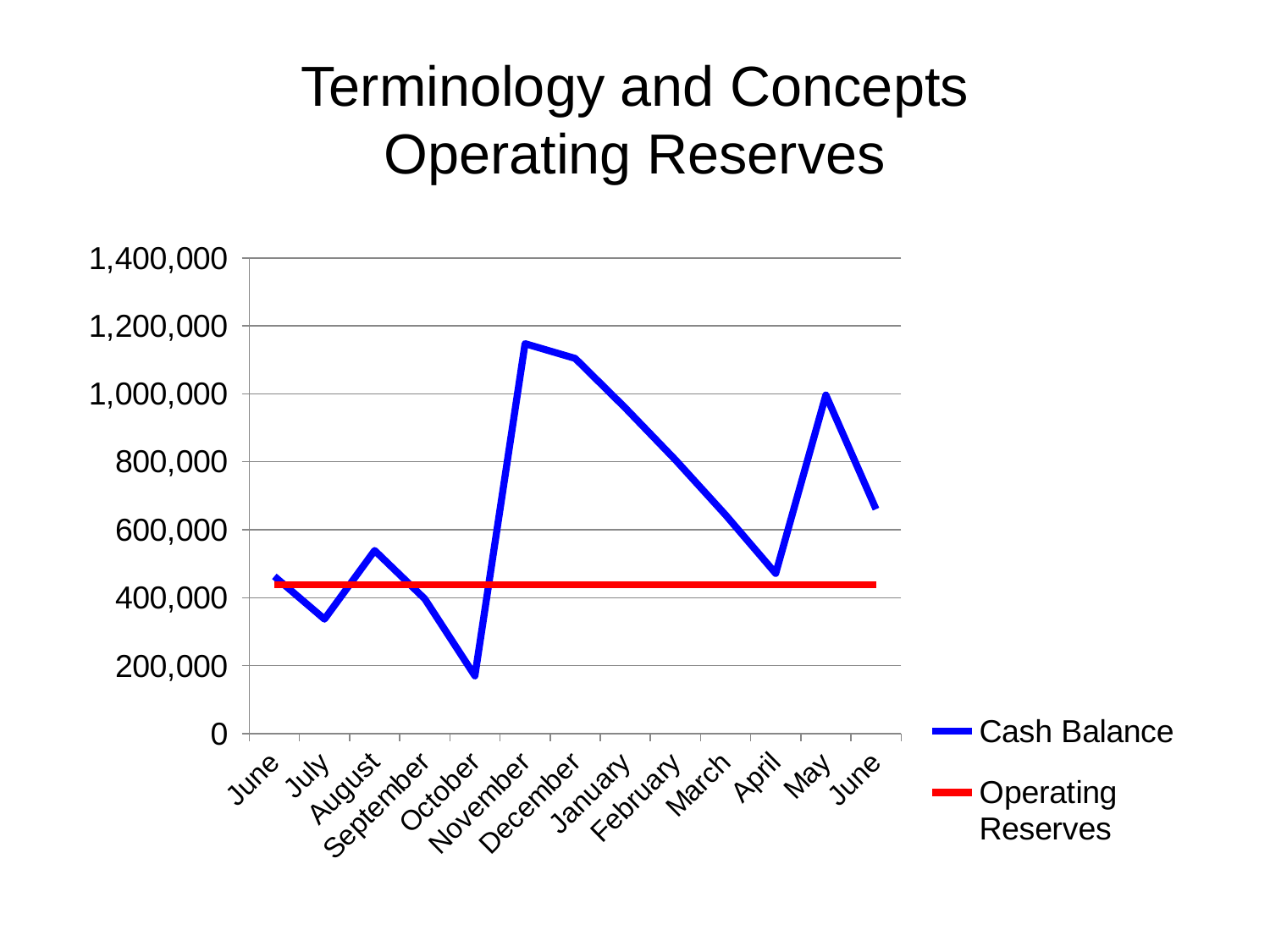
Does the Cash Balance rise or fall from November through April? Fall Which series is drawn in red? Operating Reserves Is the Cash Balance for October greater or less than 200,000? less What kind of chart is shown on the slide? Line chart Is the Cash Balance for November greater or less than 1,000,000? greater In which month is the Cash Balance lowest? October Which is larger, the Cash Balance in August or in July? August How many months are plotted along the x axis? 13 How many series does the legend list? 2 In which month is the Cash Balance highest? November Is the Cash Balance for July greater or less than 400,000? less